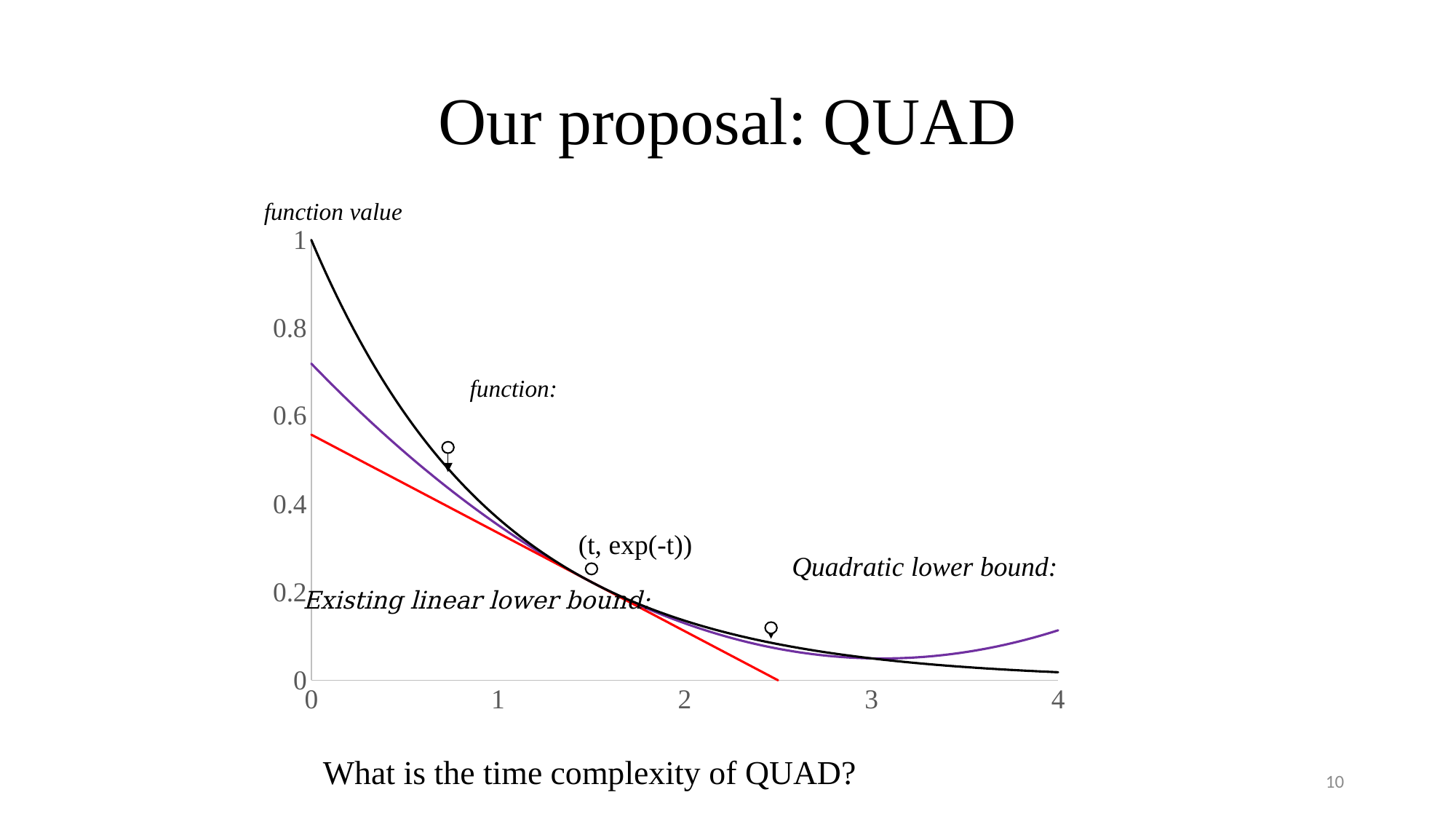
Is the value of the red linear lower bound at x = 0 greater or less than 0.6? less What kind of chart is shown on the slide? line chart At x = 4, which is higher: the purple quadratic lower bound or the black function curve? the purple quadratic lower bound What is the label on the vertical axis of the chart? function value Is the value of the purple quadratic lower bound at x = 0 greater or less than 0.6? greater At x = 0, which is higher: the black function curve or the purple quadratic lower bound? the black function curve What colour is the curve labelled 'Existing linear lower bound'? red Is the value of the black function curve at x = 4 greater or less than 0.2? less Does the black function curve rise or fall as x increases from 0 to 4? fall What is the value of the black function curve at x = 0? 1 How many curves are plotted on the chart? 3